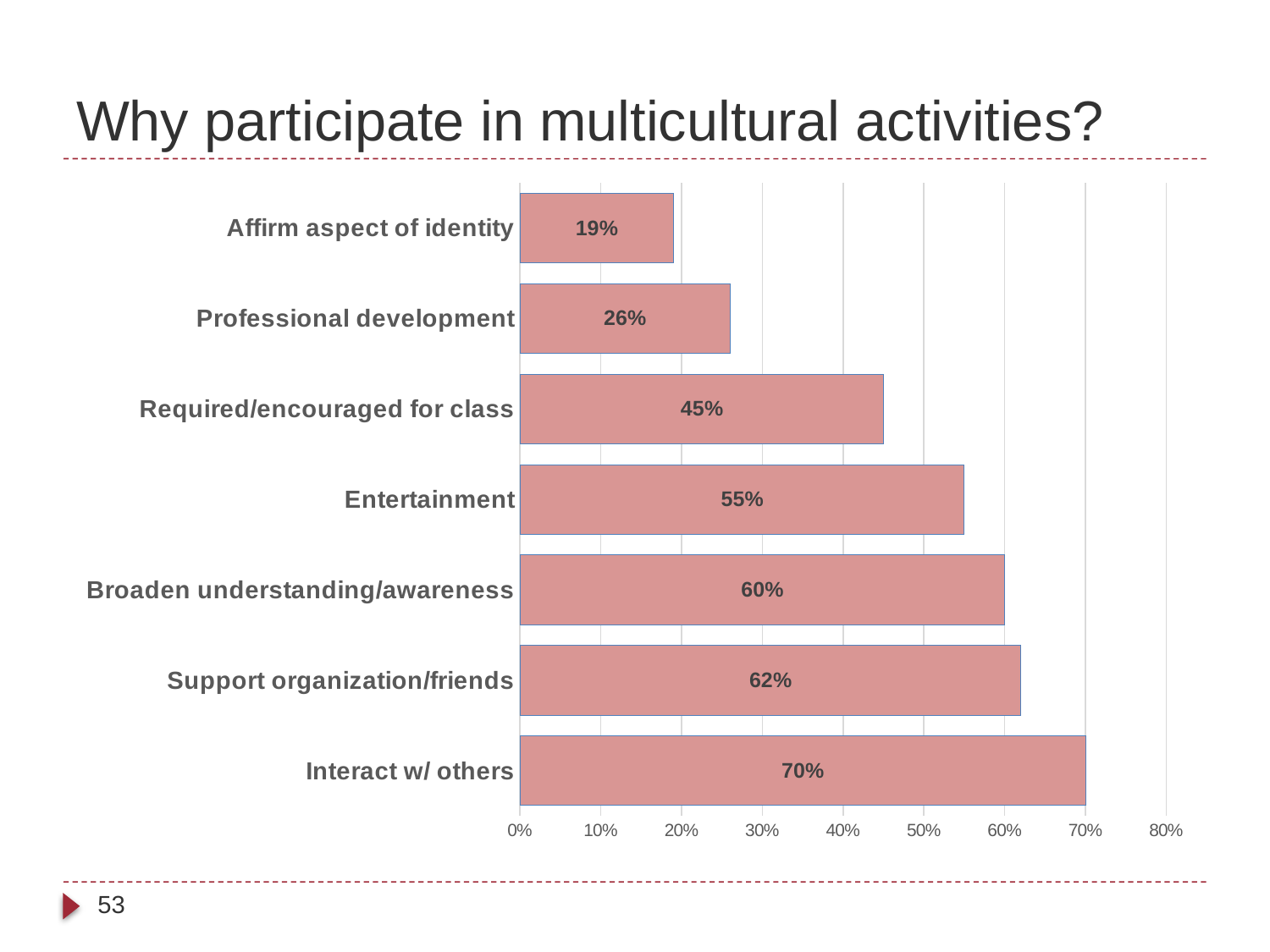
What is the value for Affirm aspect of identity? 19% What is the value for Required/encouraged for class? 45% Which category has the lowest value? Affirm aspect of identity What is the value for Interact w/ others? 70% Is the value for Entertainment greater or less than 50%? greater What is the title of the slide? Why participate in multicultural activities? What is the highest value shown on the x axis? 80% Which is larger, the value for Broaden understanding/awareness or the value for Professional development? Broaden understanding/awareness How many categories are shown in the chart? 7 What kind of chart is shown on the slide? bar chart What is the difference between the values for Support organization/friends and Entertainment? 7% Which category has the highest value? Interact w/ others